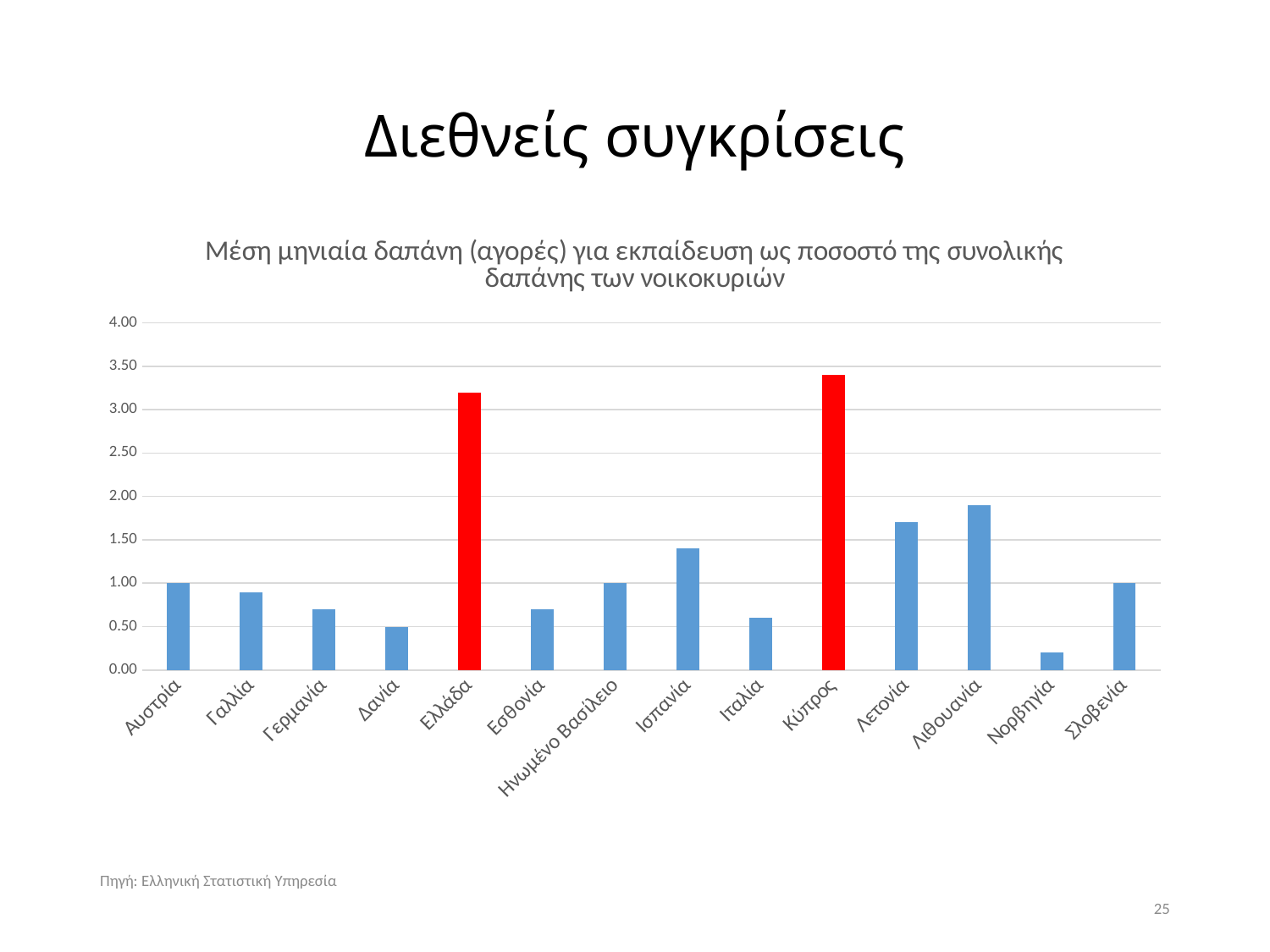
What is the value for Δανία? 0.50 Which country has the lowest value in the chart? Νορβηγία What is the value for Αυστρία? 1.00 Is the value for Νορβηγία greater or less than 0.50? less Is the value for Λιθουανία greater or less than 2.00? less Which has the larger value, Κύπρος or Ελλάδα? Κύπρος What type of chart is shown on the slide? Bar chart Which two countries' bars are coloured red in the chart? Ελλάδα and Κύπρος Is the value for Ελλάδα greater or less than 3.00? greater Which country has the highest value in the chart? Κύπρος How many countries are shown on the x axis of the chart? 14 What is the value for Σλοβενία? 1.00